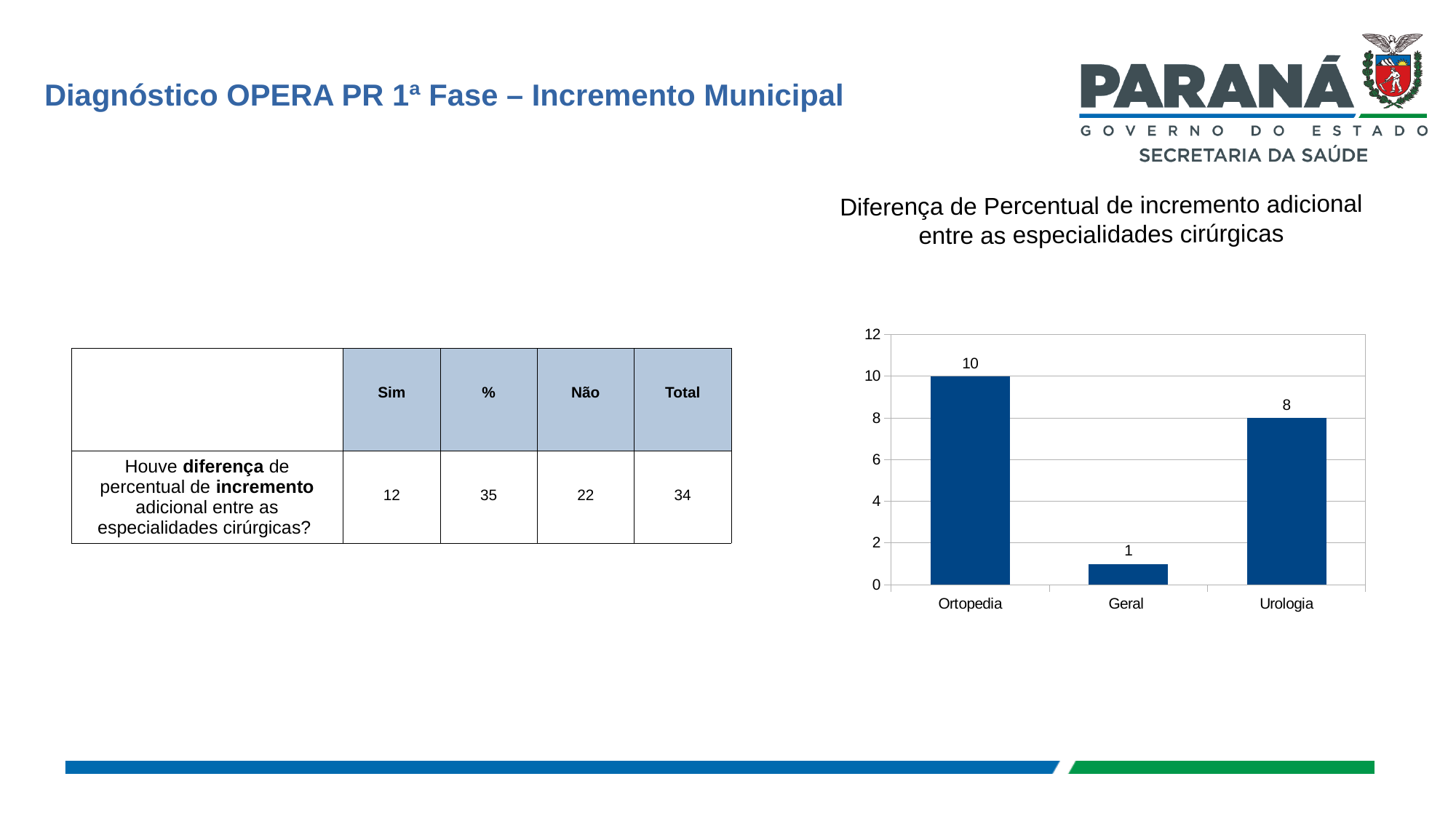
How many categories are shown on the x axis of the chart? 3 Which category has the lowest value? Geral Is the value for Urologia greater or less than 6? greater Which is larger, the value for Geral or the value for Urologia? Urologia What is the difference between the values for Ortopedia and Urologia? 2 What is the value for Ortopedia? 10 What is the difference between the values for Urologia and Geral? 7 What is the value for Geral? 1 What is the title of the chart? Diferença de Percentual de incremento adicional entre as especialidades cirúrgicas What kind of chart is shown on the slide? bar chart What is the value for Urologia? 8 Which category has the highest value? Ortopedia